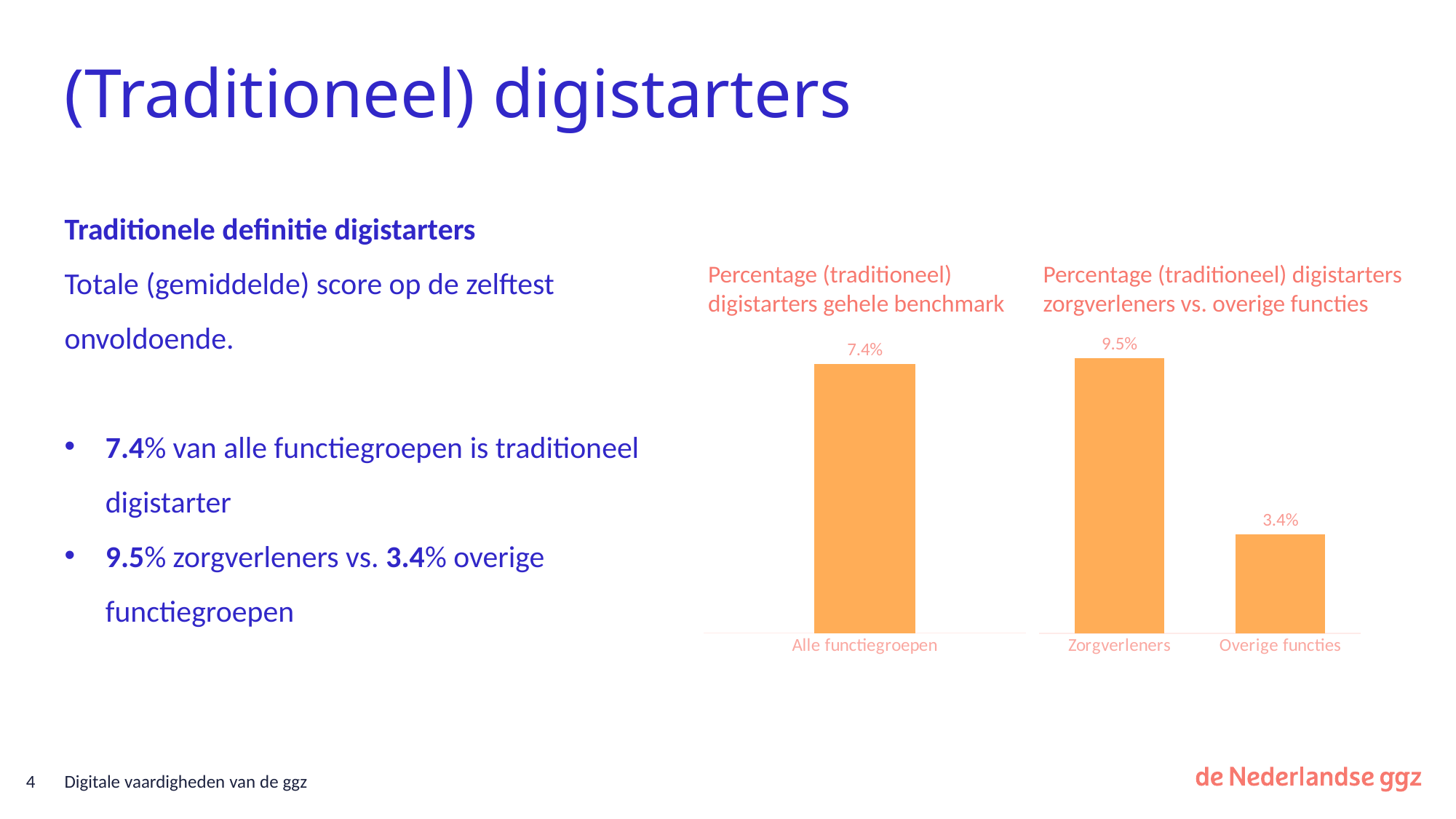
What colour are the bars in the chart 'Percentage (traditioneel) digistarters zorgverleners vs. overige functies'? Orange How many categories are shown in the chart 'Percentage (traditioneel) digistarters zorgverleners vs. overige functies'? 2 In the chart 'Percentage (traditioneel) digistarters zorgverleners vs. overige functies', what is the value for Zorgverleners? 9.5% What type of chart is the chart 'Percentage (traditioneel) digistarters gehele benchmark'? Bar chart How many categories are shown in the chart 'Percentage (traditioneel) digistarters gehele benchmark'? 1 In the chart 'Percentage (traditioneel) digistarters gehele benchmark', what is the value for Alle functiegroepen? 7.4% In the chart 'Percentage (traditioneel) digistarters zorgverleners vs. overige functies', what is the difference between Zorgverleners and Overige functies? 6.1% In the chart 'Percentage (traditioneel) digistarters zorgverleners vs. overige functies', which is larger: Zorgverleners or Overige functies? Zorgverleners In the chart 'Percentage (traditioneel) digistarters zorgverleners vs. overige functies', do the values rise or fall from left to right? Fall In the chart 'Percentage (traditioneel) digistarters zorgverleners vs. overige functies', which category has the lowest value? Overige functies In the chart 'Percentage (traditioneel) digistarters zorgverleners vs. overige functies', which category has the highest value? Zorgverleners In the chart 'Percentage (traditioneel) digistarters zorgverleners vs. overige functies', what is the value for Overige functies? 3.4%